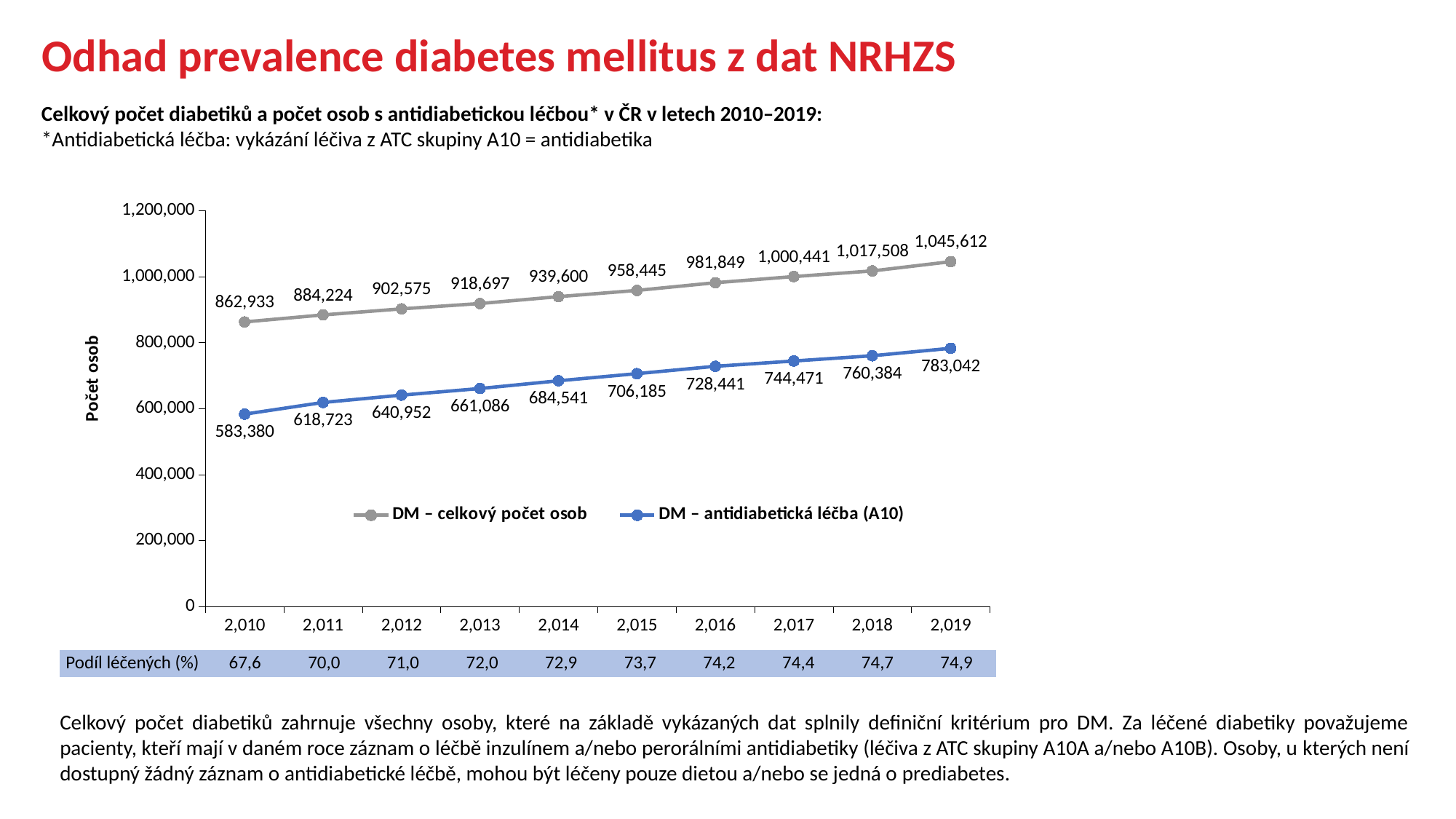
How many series does the legend list? 2 In which year is DM – celkový počet osob highest? 2019 What is the value for DM – celkový počet osob in 2014? 939,600 How many years are plotted on the x axis? 10 Which series has the larger value in 2015, DM – celkový počet osob or DM – antidiabetická léčba (A10)? DM – celkový počet osob What is the value for DM – celkový počet osob in 2019? 1,045,612 What kind of chart is shown on the slide? line chart What is the value for DM – antidiabetická léčba (A10) in 2010? 583,380 In which year is DM – antidiabetická léčba (A10) lowest? 2010 Do the values for DM – antidiabetická léčba (A10) rise or fall from 2010 to 2019? rise What is the difference between DM – celkový počet osob and DM – antidiabetická léčba (A10) in 2019? 262,570 What is the value for DM – antidiabetická léčba (A10) in 2016? 728,441